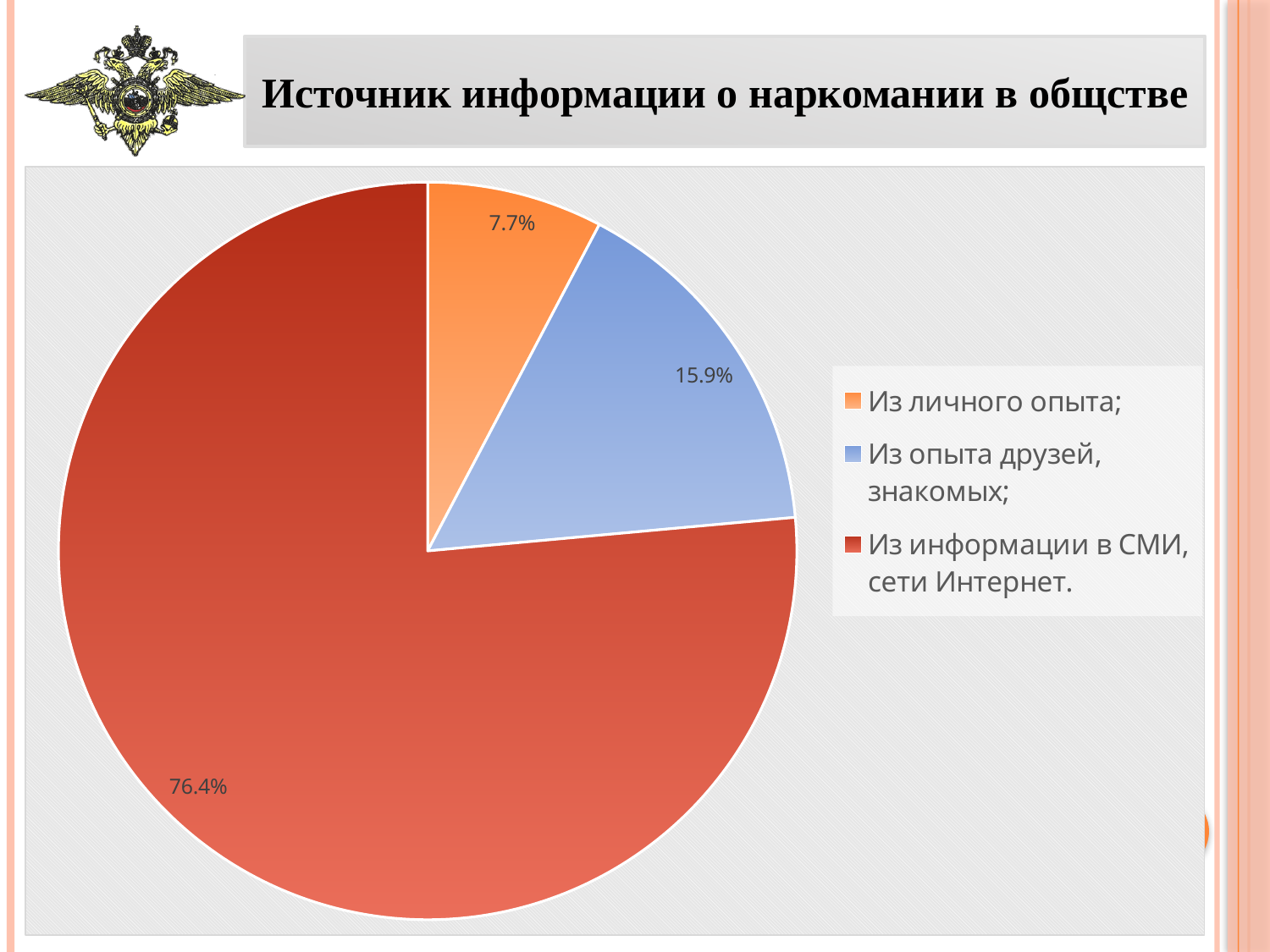
How many slices does the pie chart have? 3 What is the difference between the shares for 'Из информации в СМИ, сети Интернет' and 'Из опыта друзей, знакомых'? 60.5% What is the title of the slide containing the chart? Источник информации о наркомании в обществе What share of the pie is labelled 'Из опыта друзей, знакомых'? 15.9% Which category has the smallest slice of the pie? Из личного опыта What colour is the slice for 'Из опыта друзей, знакомых'? blue Which category has the largest slice of the pie? Из информации в СМИ, сети Интернет What kind of chart is shown on the slide? pie chart What is the difference between the shares for 'Из опыта друзей, знакомых' and 'Из личного опыта'? 8.2% What share of the pie is labelled 'Из личного опыта'? 7.7% What share of the pie is labelled 'Из информации в СМИ, сети Интернет'? 76.4% Which is larger: the share for 'Из опыта друзей, знакомых' or the share for 'Из личного опыта'? Из опыта друзей, знакомых